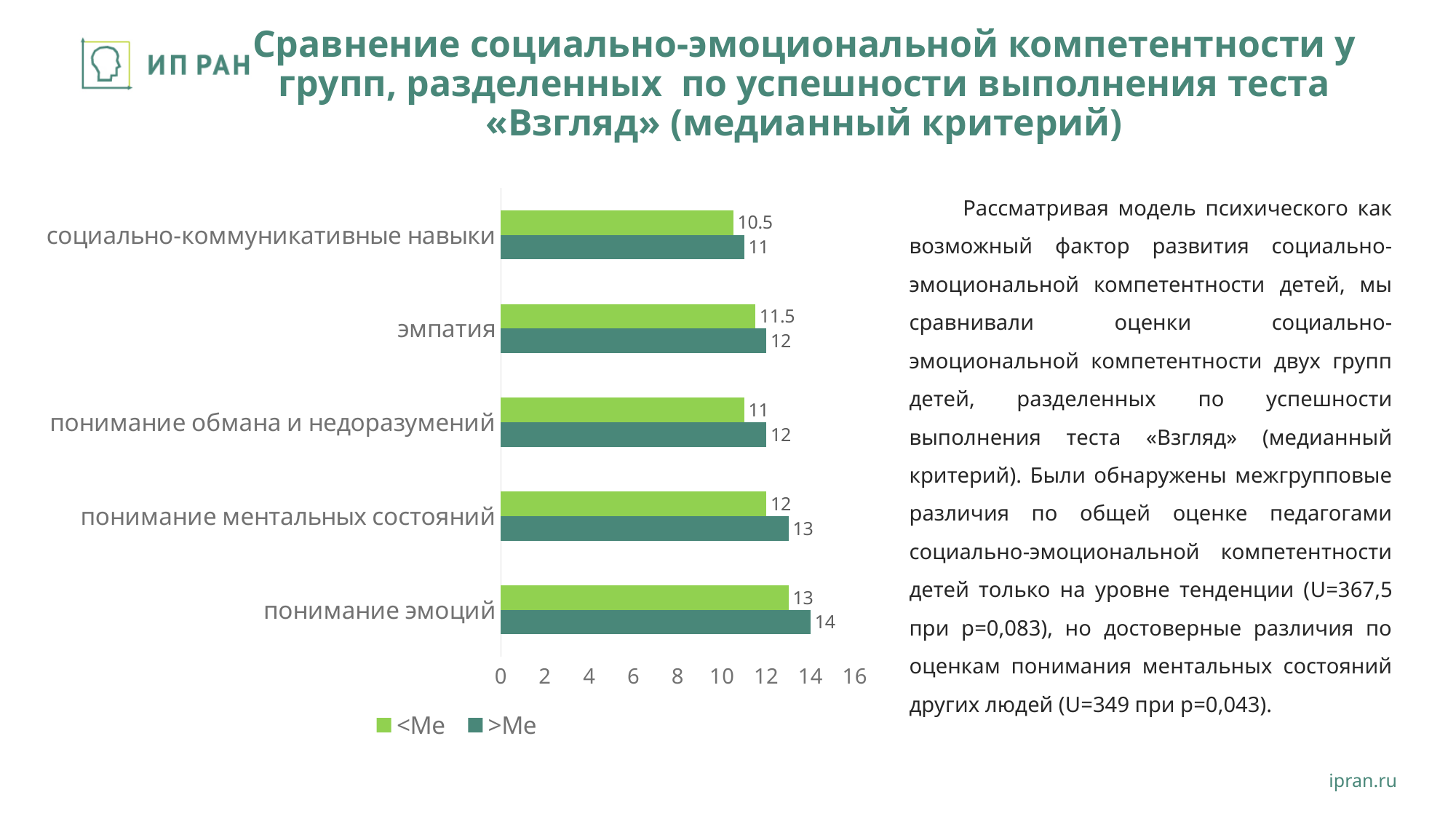
What is the value for "эмпатия" in the "<Me" series? 11.5 Which colour represents the ">Me" series in the legend? dark green What is the value for "понимание эмоций" in the ">Me" series? 14 How many series does the legend list? 2 What is the value for "социально-коммуникативные навыки" in the "<Me" series? 10.5 How many categories are shown on the chart? 5 What is the difference between the ">Me" and "<Me" values for "социально-коммуникативные навыки"? 0.5 What type of chart is shown on the slide? bar chart Which category has the highest value in the ">Me" series? понимание эмоций For "понимание ментальных состояний", which series has the larger value, "<Me" or ">Me"? >Me What is the difference between the ">Me" and "<Me" values for "понимание эмоций"? 1 Which category has the lowest value in the "<Me" series? социально-коммуникативные навыки